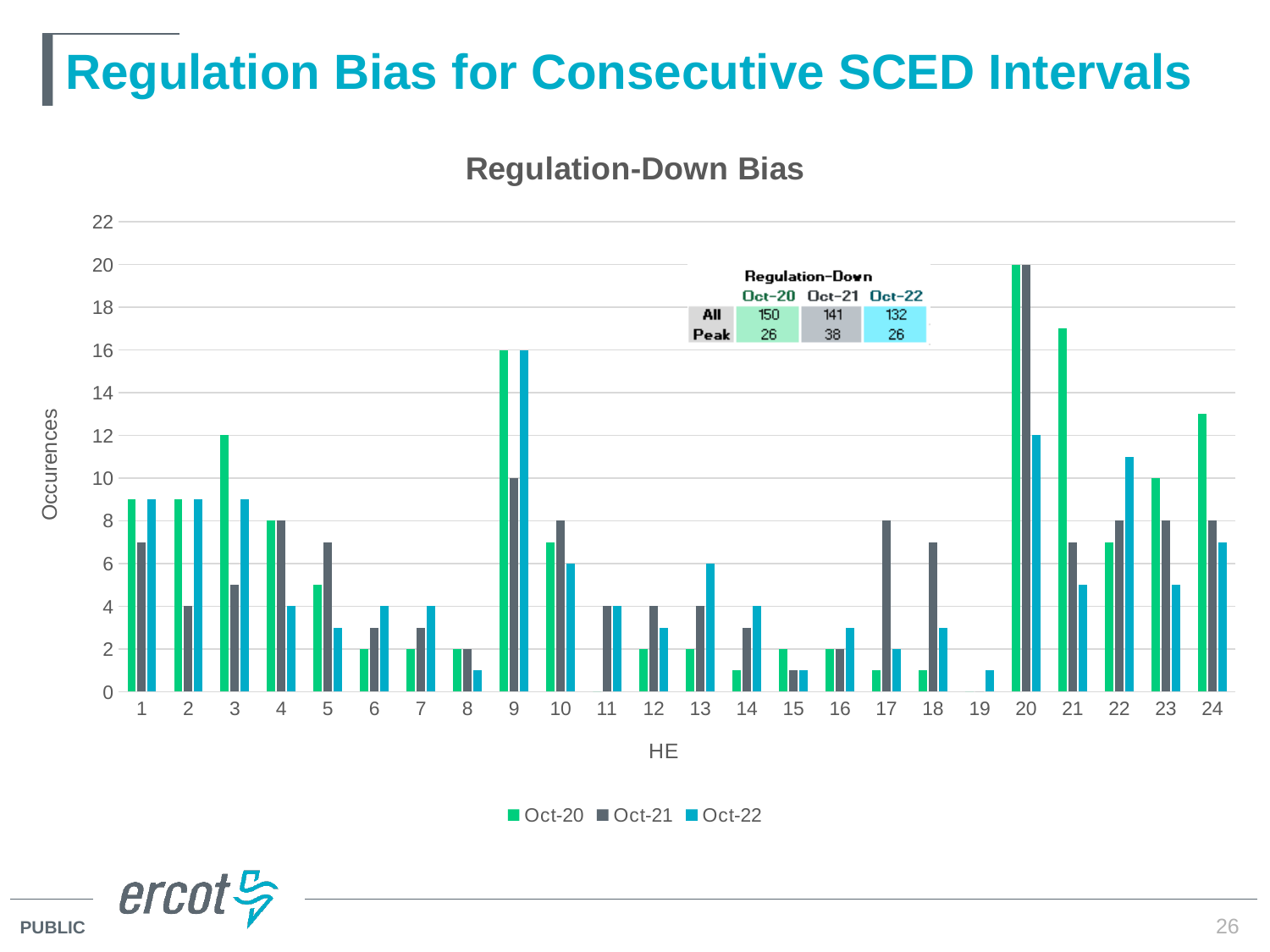
In the inset table, what is the 'All' value for Oct-20? 150 What kind of chart is shown on the slide? bar chart How many HE categories are shown on the x axis? 24 In the inset table, what is the difference between the 'All' values for Oct-20 and Oct-22? 18 According to the inset table, which month has the lowest 'All' value? Oct-22 What is the title of the chart? Regulation-Down Bias How many series does the legend list? 3 In the inset table, what is the 'Peak' value for Oct-21? 38 At HE 9, which series is larger, Oct-20 or Oct-21? Oct-20 At which HE does the Oct-22 series reach its highest value? 9 Is the Oct-20 value at HE 3 greater or less than 10? greater What is the Oct-20 value at HE 20? 20